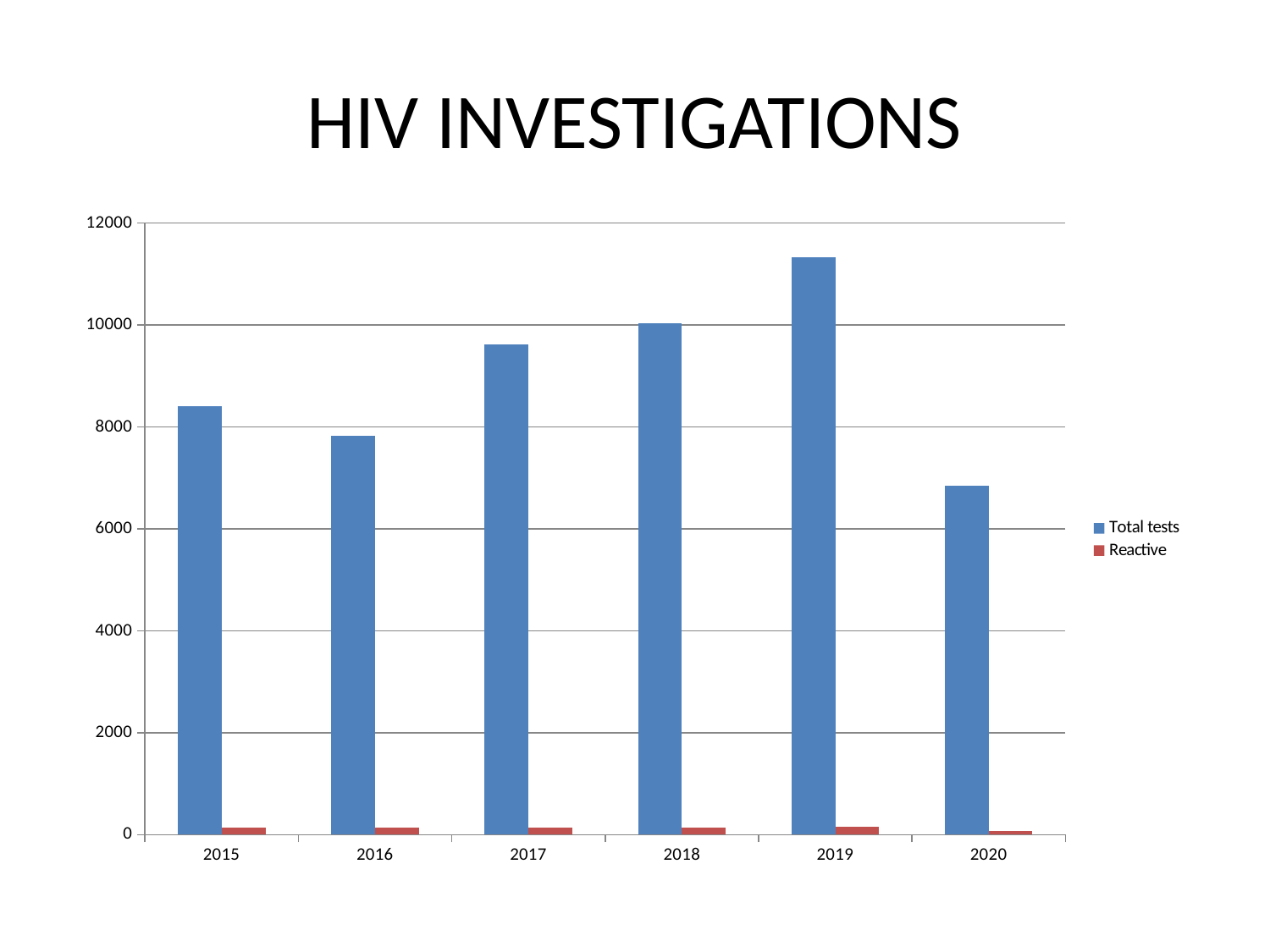
Is the value for Total tests in 2020 greater or less than 6000? greater Which year has the lowest value for Reactive? 2020 Which is larger, Total tests in 2017 or Total tests in 2016? 2017 How many series does the legend list? 2 Which year has the lowest value for Total tests? 2020 Is the value for Total tests in 2016 greater or less than 8000? less What kind of chart is shown on the slide? bar chart Which year has the highest value for Total tests? 2019 Between 2016 and 2019, do the Total tests values rise or fall? rise How many years are shown on the x axis? 6 Is the value for Total tests in 2019 greater or less than 10000? greater What is the title of the chart? HIV INVESTIGATIONS